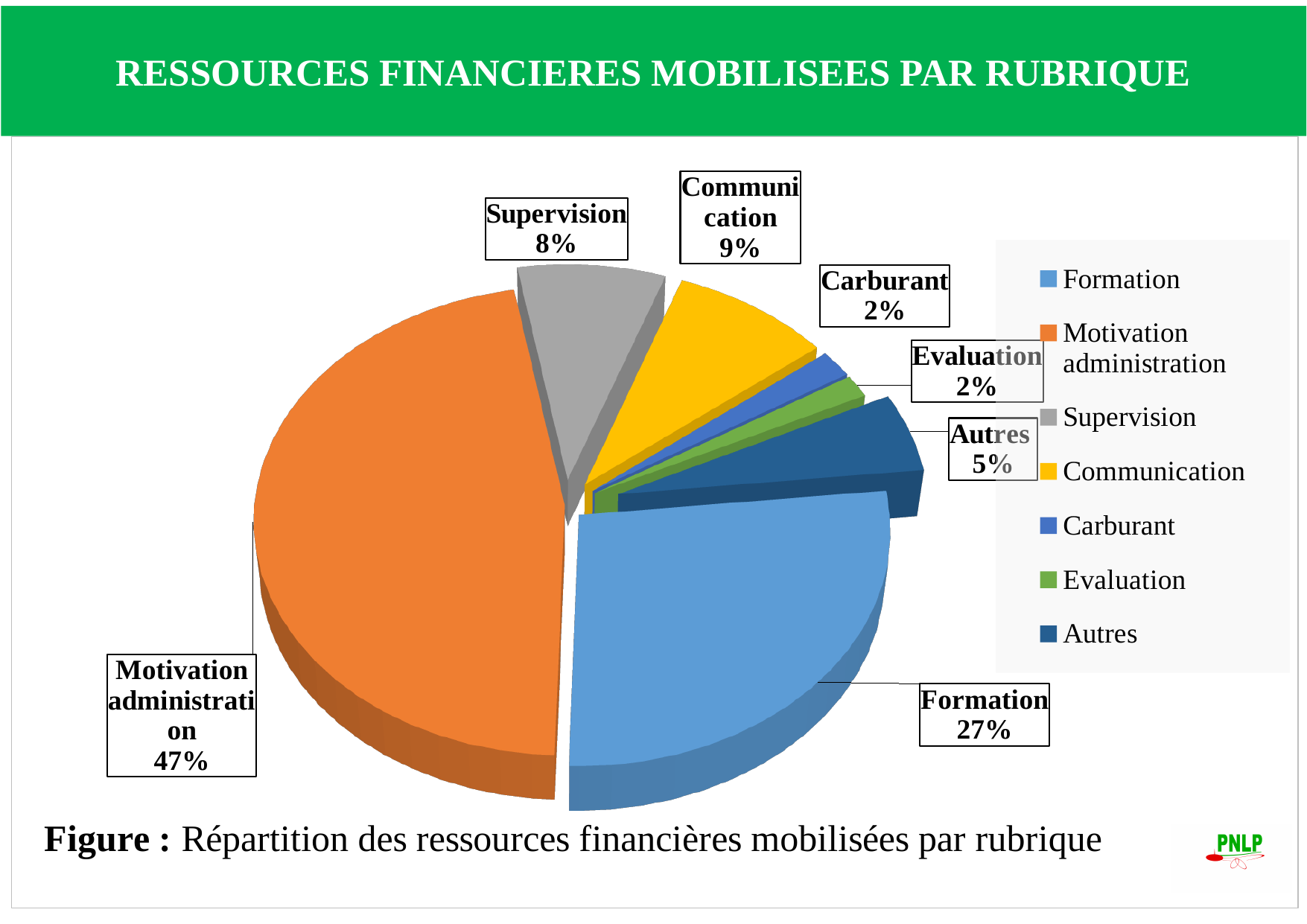
What is the value shown for Supervision? 8% What is the value shown for Formation? 27% Which category has the largest share of the pie? Motivation administration What is the combined share of Carburant and Evaluation? 4% How many categories are shown in the pie chart? 7 What is the value shown for Autres? 5% What is the difference between the shares of Motivation administration and Formation? 20% What colour is the Supervision slice in the pie chart? Grey What kind of chart is shown on the slide? Pie chart What share of the pie does Motivation administration represent? 47% What is the value shown for Communication? 9% Which is larger, the share for Communication or the share for Supervision? Communication